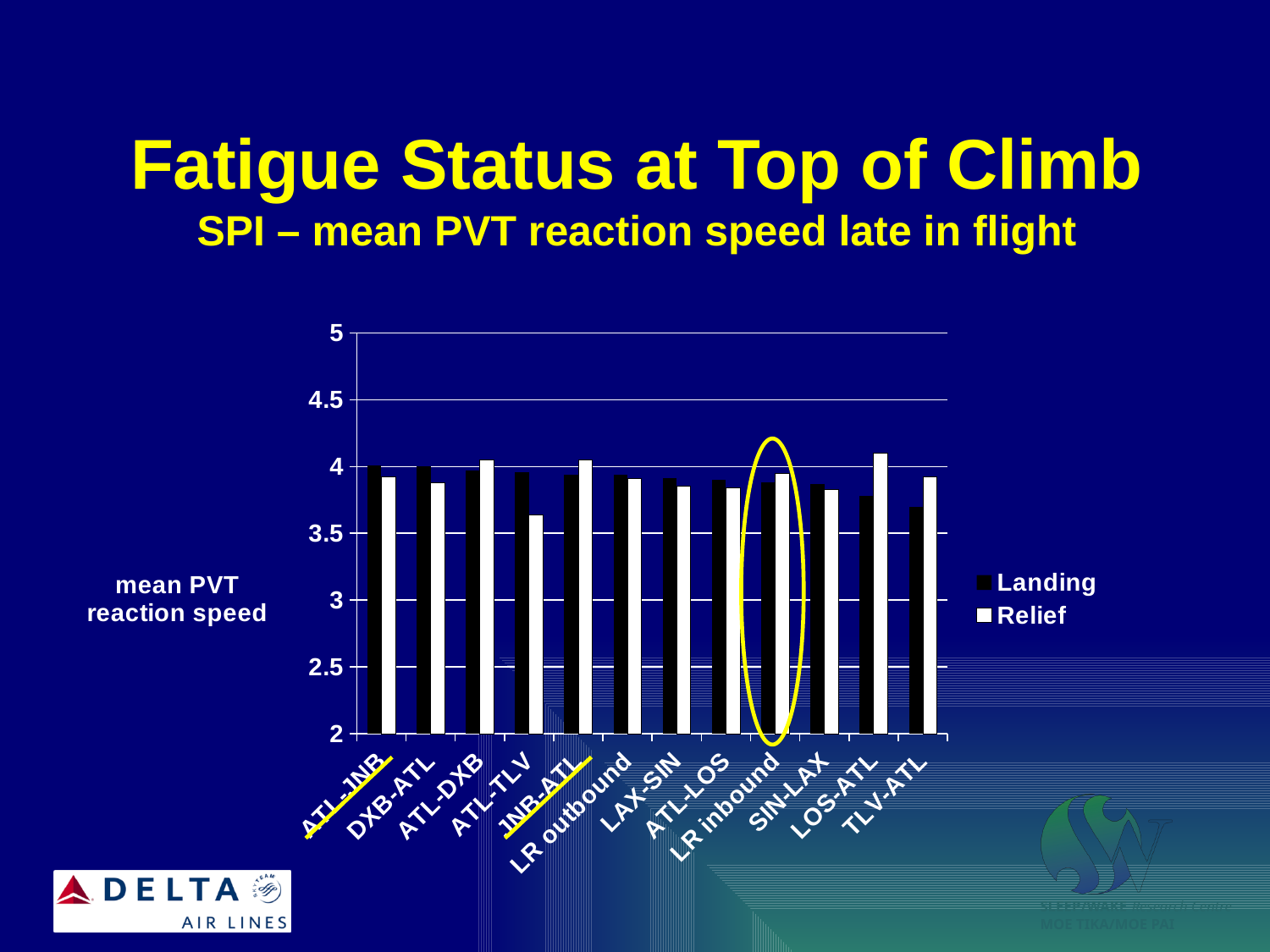
Is the Relief value for ATL-TLV greater or less than 4? less For TLV-ATL, which is larger, the Landing value or the Relief value? Relief For ATL-TLV, which is larger, the Landing value or the Relief value? Landing What kind of chart is shown on the slide? bar chart How many series does the legend list? 2 Which category has the lowest Relief value? ATL-TLV How many categories are shown on the x axis? 12 What are the two series named in the legend? Landing and Relief Is the Landing value for TLV-ATL greater or less than 4? less Is the Relief value for ATL-TLV greater or less than 3.5? greater For LOS-ATL, which is larger, the Landing value or the Relief value? Relief